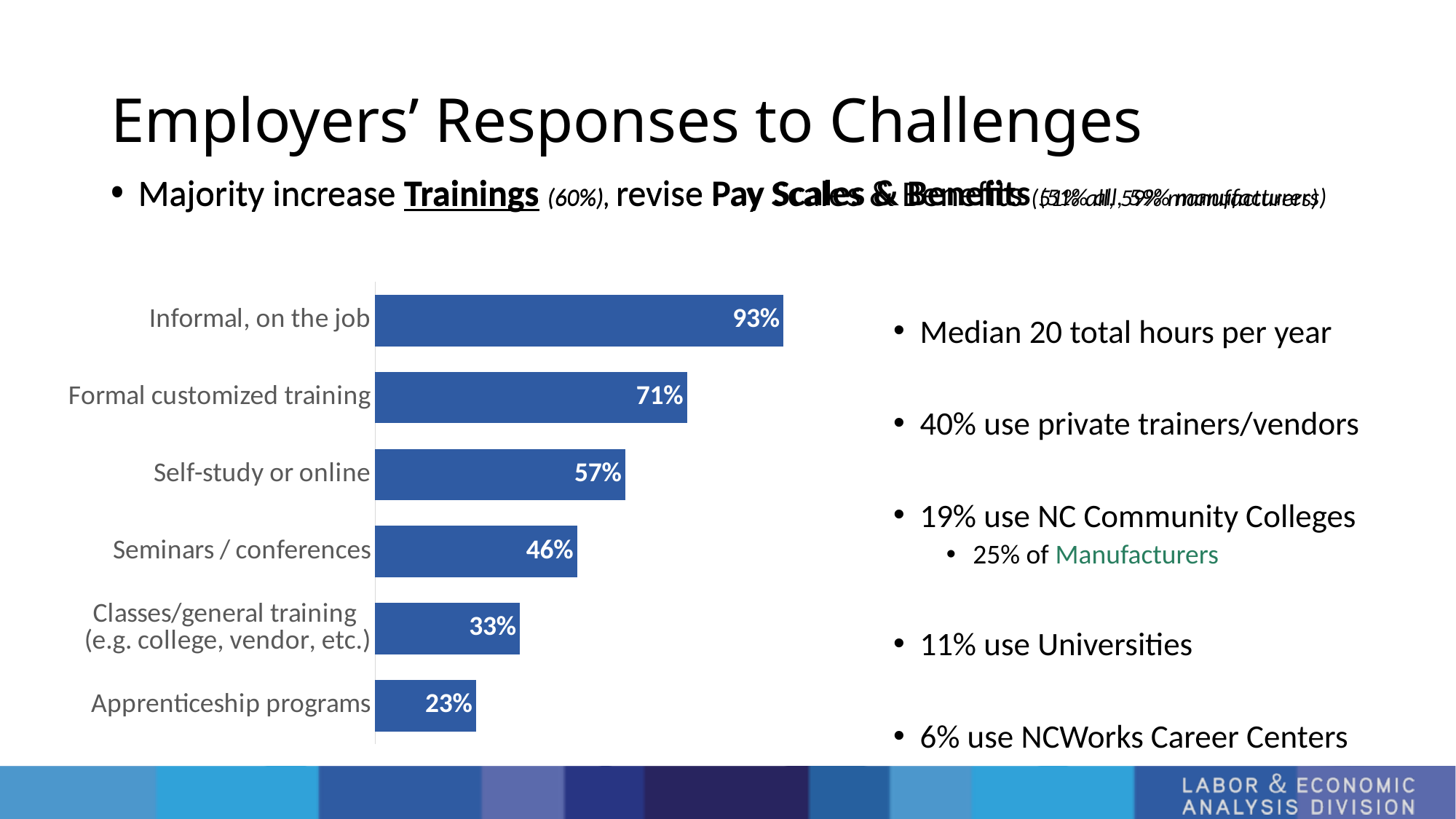
Which is larger, Self-study or online or Seminars / conferences? Self-study or online What is the value for Self-study or online? 57% What kind of chart is shown on the slide? Bar chart Which category has the highest value? Informal, on the job Which category has the lowest value? Apprenticeship programs How many categories does the chart show? 6 What colour are the bars in the chart? Blue What is the value for Informal, on the job? 93% What is the difference between Informal, on the job and Formal customized training? 22% What is the value for Formal customized training? 71% What is the value for Apprenticeship programs? 23% What is the difference between Seminars / conferences and Apprenticeship programs? 23%